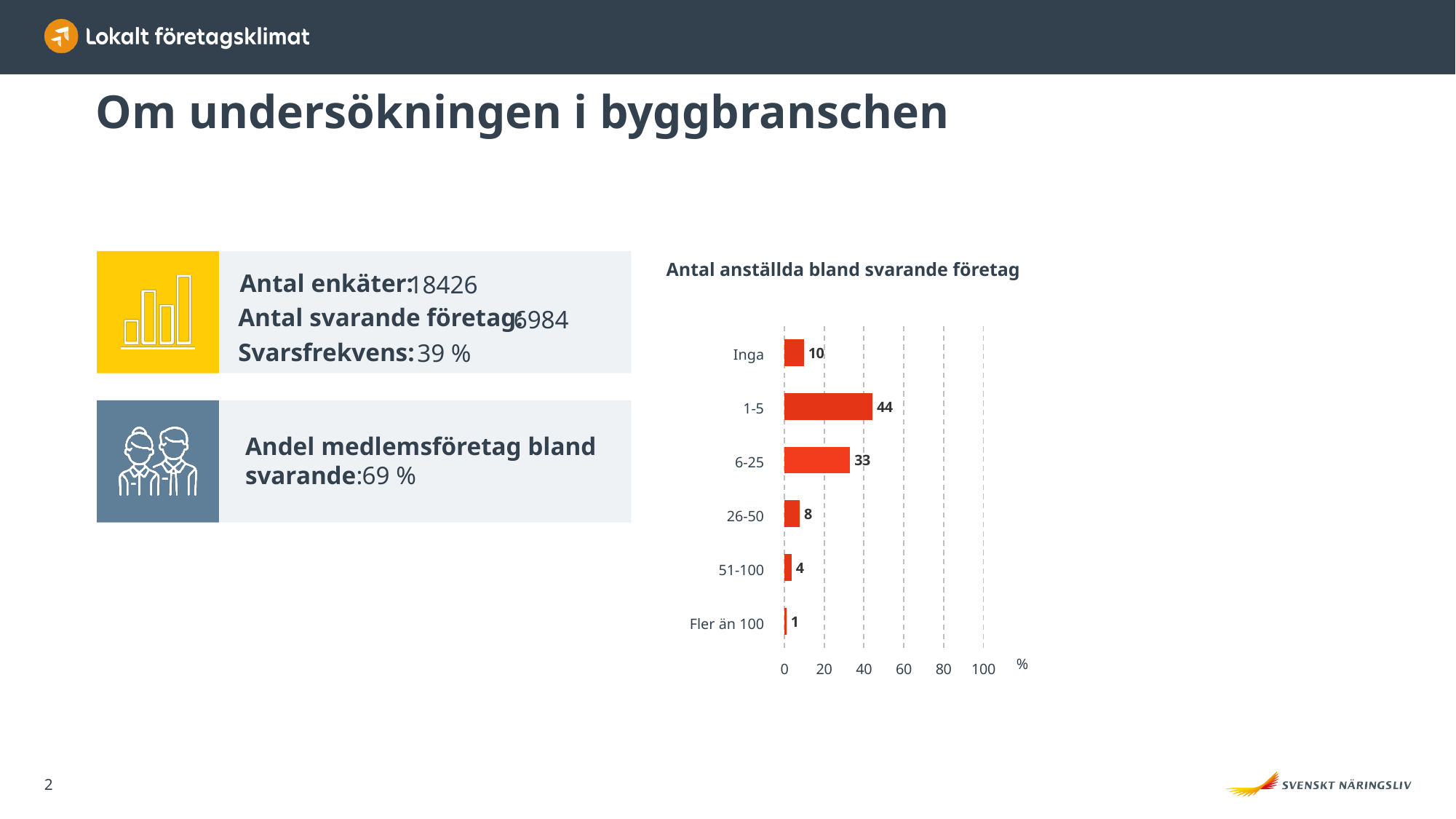
Which category has the lowest value? Fler än 100 What is the difference between the values for '1-5' and '6-25'? 11 What is the value for 'Fler än 100'? 1 What is the title of the chart? Antal anställda bland svarande företag Which is larger, the value for 'Inga' or the value for '26-50'? Inga What is the value for 'Inga'? 10 Is the value for '1-5' greater or less than 40? greater What is the value for the '1-5' category in the chart? 44 What kind of chart is shown on the slide? bar chart Which category has the highest value? 1-5 What is the value for the '6-25' category? 33 How many categories are shown in the chart? 6